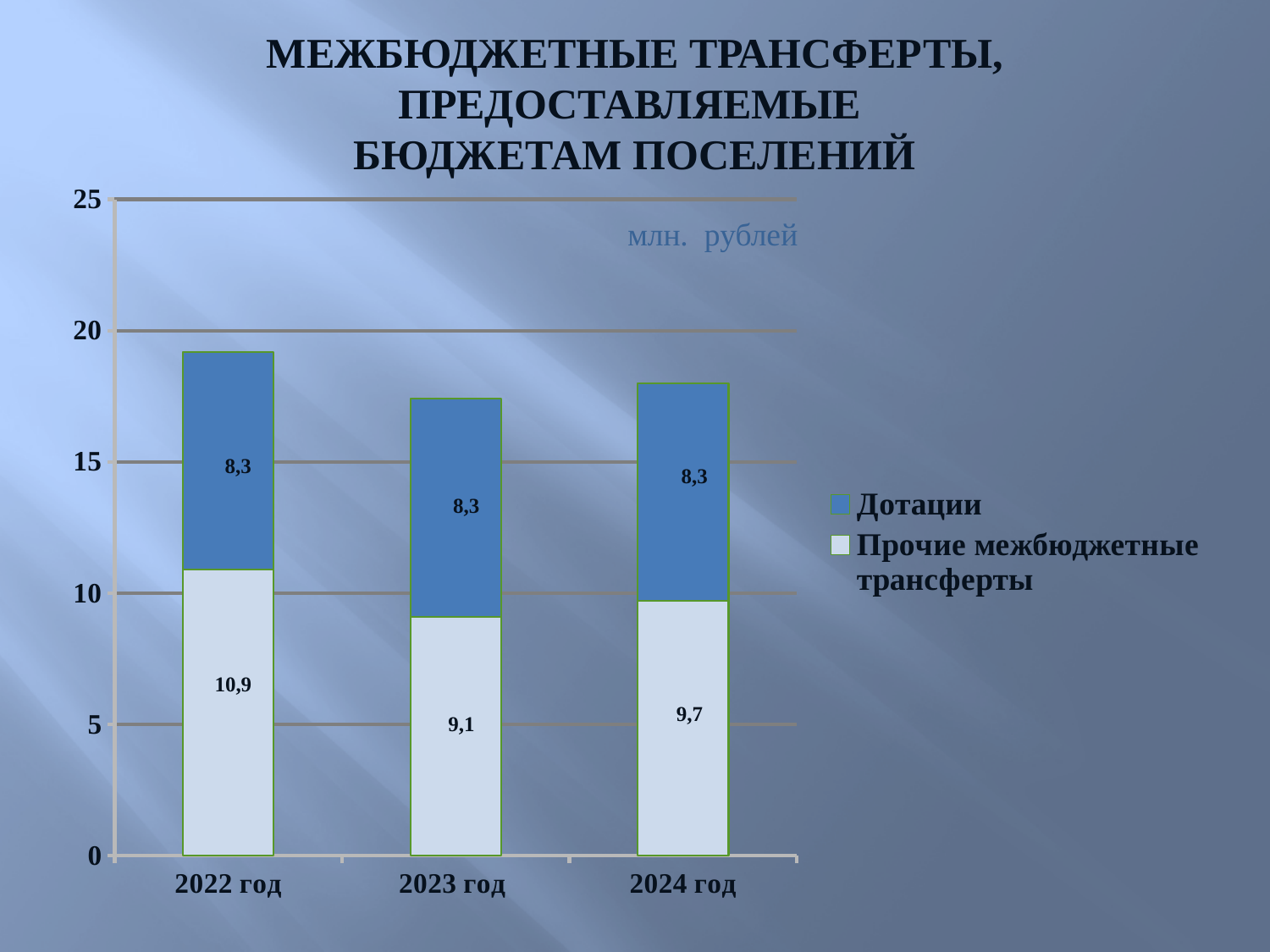
What is the total of the stacked bar for 2022 год? 19,2 What is the value of Прочие межбюджетные трансферты for 2022 год? 10,9 What is the value of Дотации for 2023 год? 8,3 Which is larger: Прочие межбюджетные трансферты in 2024 год or in 2023 год? 2024 год What is the difference between Прочие межбюджетные трансферты in 2022 год and 2023 год? 1,8 Which year has the lowest value for Прочие межбюджетные трансферты? 2023 год What is the value of Прочие межбюджетные трансферты for 2024 год? 9,7 How many series does the legend list? 2 What is the total of the stacked bar for 2023 год? 17,4 Which year has the highest value for Прочие межбюджетные трансферты? 2022 год How many years are shown on the x axis? 3 What kind of chart is shown on the slide? Stacked bar chart